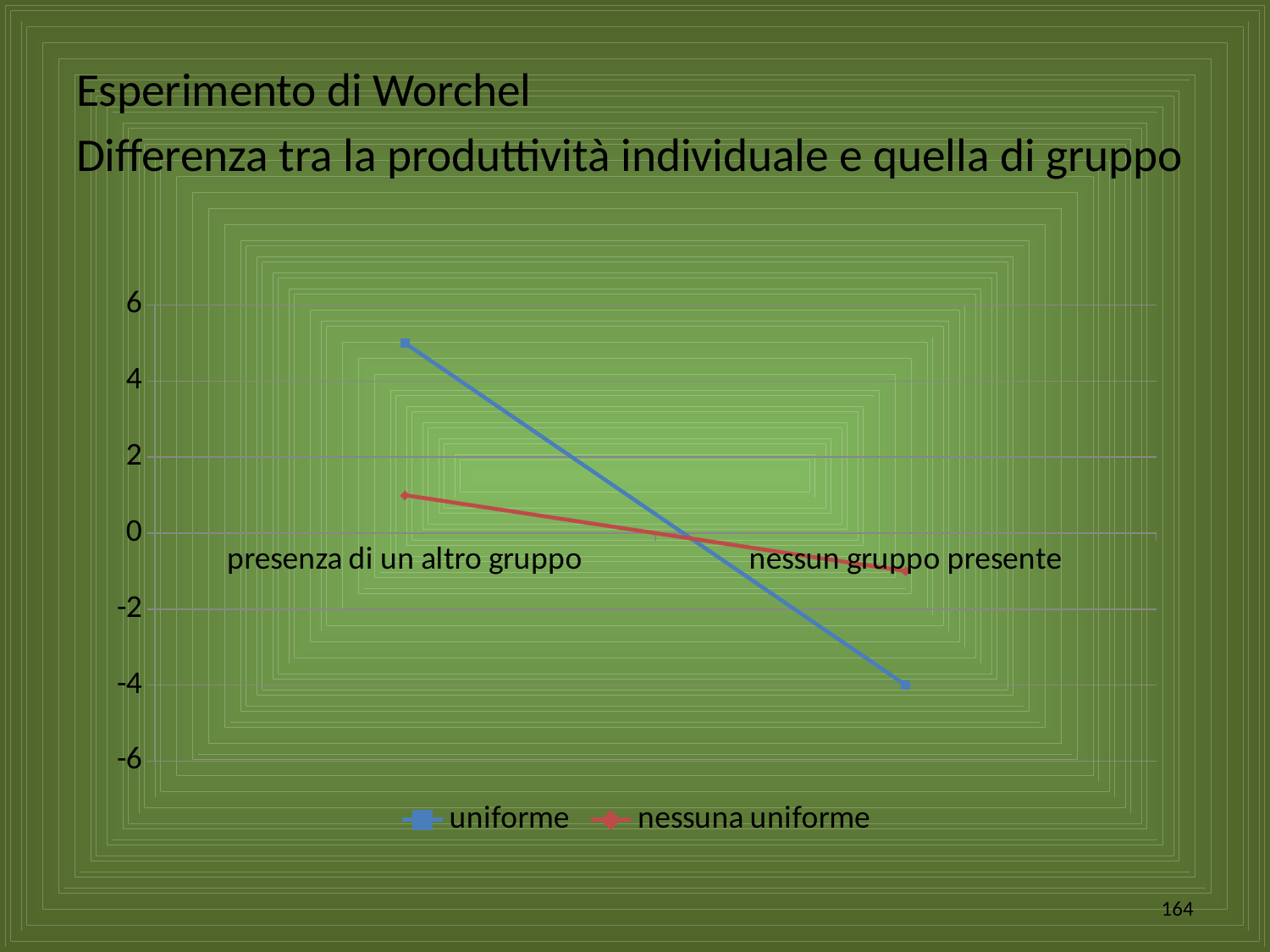
Does the 'nessuna uniforme' series rise or fall along the x axis? fall What is the value of the 'uniforme' series for 'nessun gruppo presente'? -4 What kind of chart is shown on the slide? line chart How many categories are shown on the x axis? 2 Which series is drawn in blue? uniforme Is the value of the 'nessuna uniforme' series for 'nessun gruppo presente' greater or less than 0? less How many series does the legend list? 2 Is the value of the 'uniforme' series for 'presenza di un altro gruppo' greater or less than 4? greater Does the 'uniforme' series rise or fall from 'presenza di un altro gruppo' to 'nessun gruppo presente'? fall Which series has the higher value for 'presenza di un altro gruppo'? uniforme Which series has the lower value for 'nessun gruppo presente'? uniforme Is the value of the 'nessuna uniforme' series for 'presenza di un altro gruppo' greater or less than 0? greater